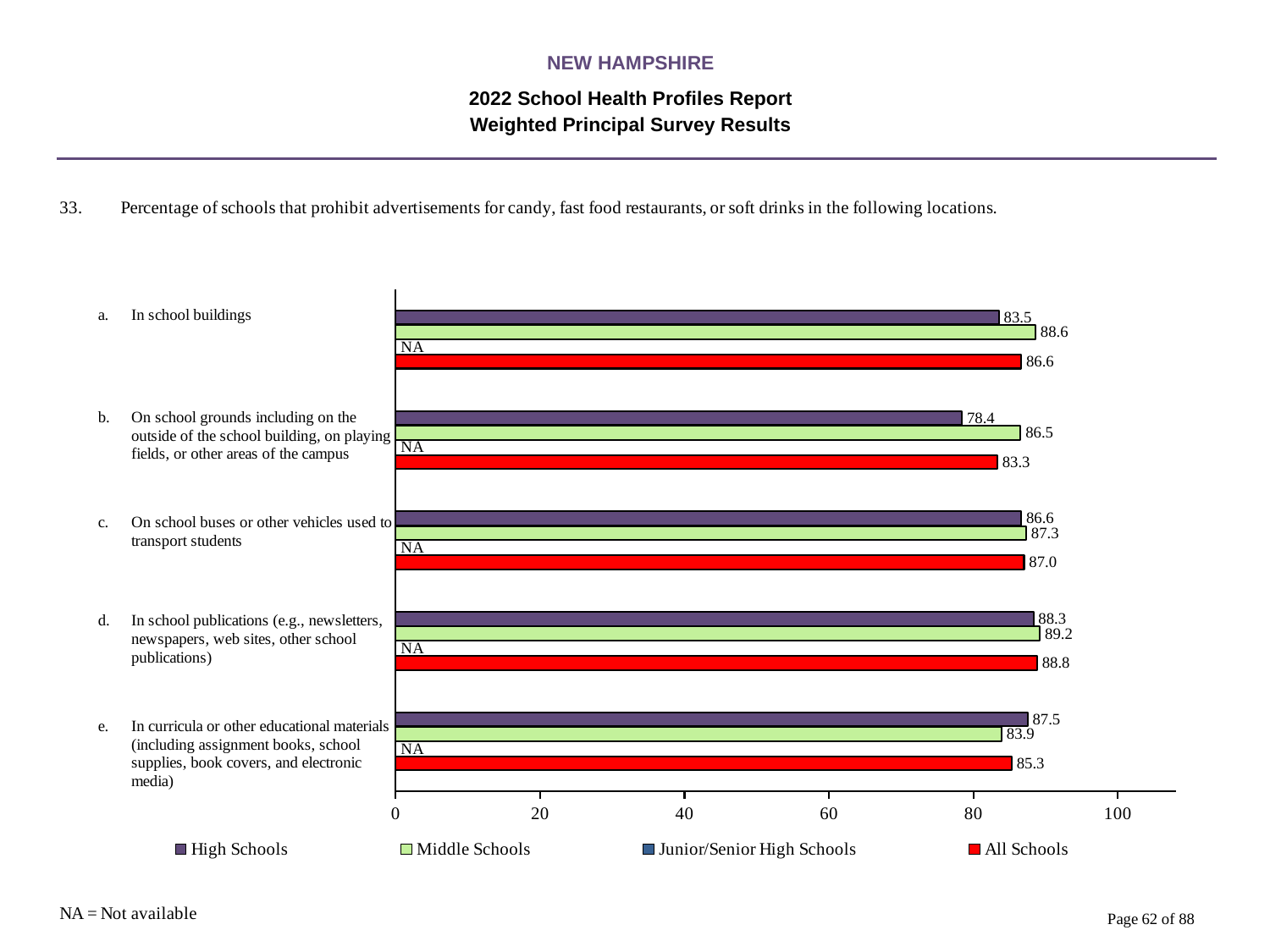
How many series does the legend list? 4 What is the Middle Schools value for 'On school grounds including on the outside of the school building, on playing fields, or other areas of the campus'? 86.5 What is the High Schools value for 'In school buildings'? 83.5 How many locations (categories) are shown in the chart? 5 What is the difference between the Middle Schools and High Schools values for 'In school buildings'? 5.1 What is the All Schools value for 'In curricula or other educational materials'? 85.3 Which location has the highest All Schools value? In school publications (e.g., newsletters, newspapers, web sites, other school publications) For 'In curricula or other educational materials', which is larger: the High Schools value or the Middle Schools value? High Schools What type of chart is shown on the slide? Bar chart Which location has the lowest High Schools value? On school grounds including on the outside of the school building, on playing fields, or other areas of the campus What is the All Schools value for 'On school buses or other vehicles used to transport students'? 87.0 What is the Middle Schools value for 'In school publications'? 89.2